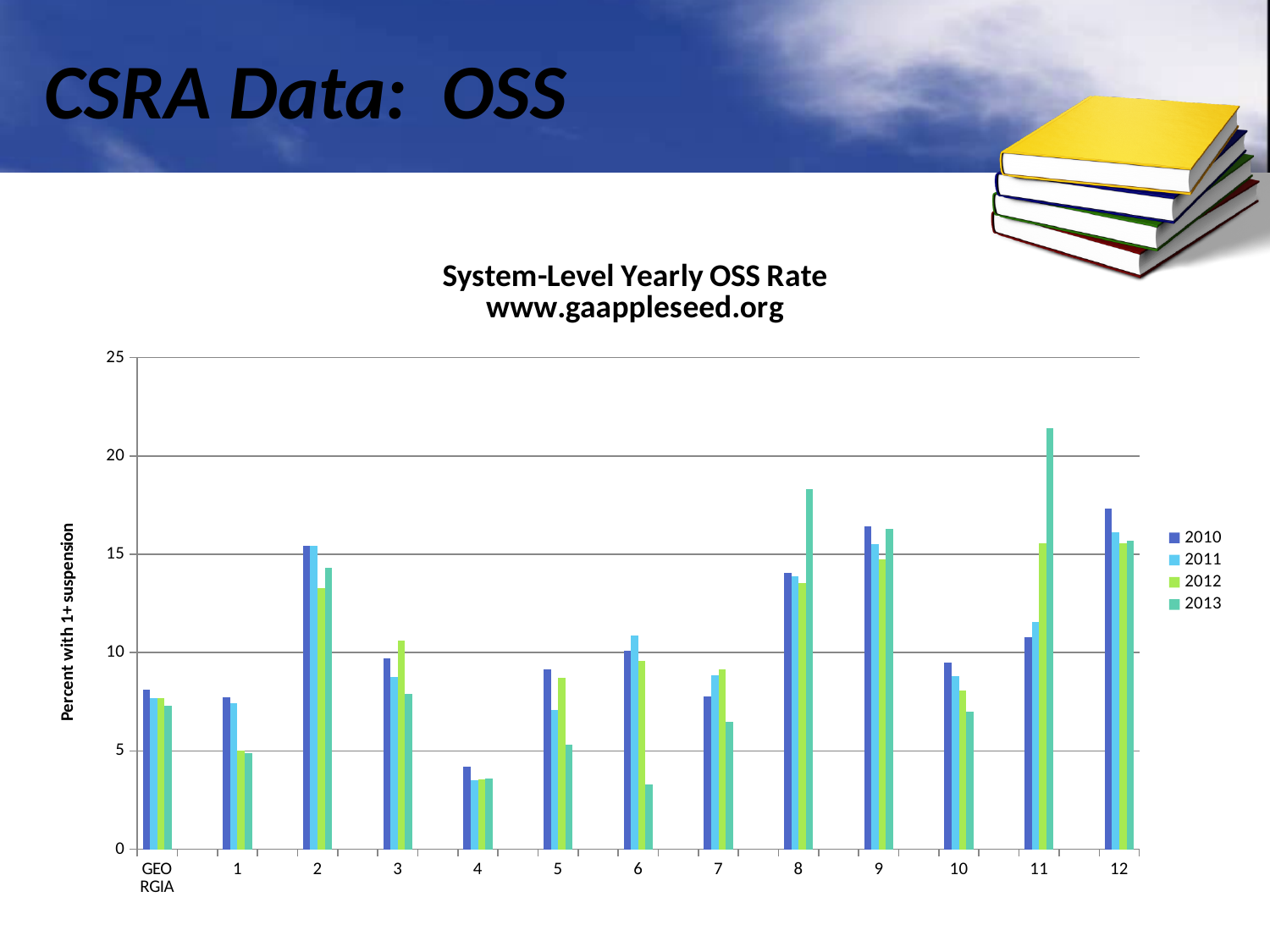
Is the 2013 value for category 11 greater or less than 20? greater Is the 2010 value for category 12 greater or less than 15? greater What is the title of the chart? System-Level Yearly OSS Rate www.gaappleseed.org Which category has the lowest 2010 value? 4 Which category has the highest 2013 value? 11 What is the label on the vertical axis? Percent with 1+ suspension How many categories are shown along the x axis? 13 For category 8, which is larger: the 2010 value or the 2013 value? 2013 Is the 2013 value for category 6 greater or less than 5? less What kind of chart is shown on the slide? bar chart How many series does the legend list? 4 For category 11, do the values rise or fall from 2010 to 2013? rise